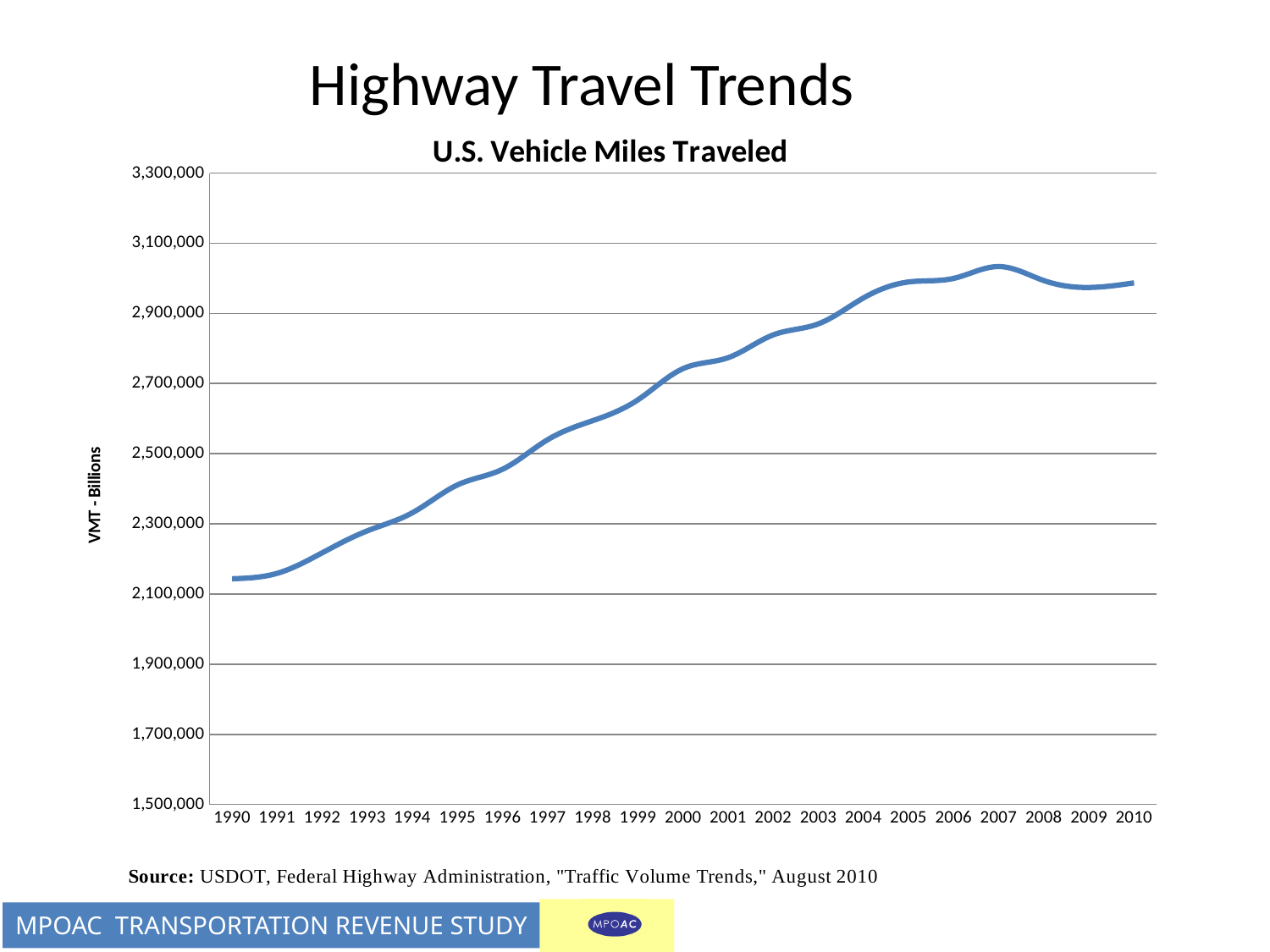
What is the title of the chart? U.S. Vehicle Miles Traveled Which year has the lowest vehicle miles traveled value? 1990 Is the value for 1995 greater or less than 2,500,000? less Is the value for 1990 greater or less than 2,300,000? less Is the value for 2007 greater or less than 3,100,000? less How many years are shown along the x axis of the chart? 21 Which year has the larger value, 2007 or 2009? 2007 Which year has the highest vehicle miles traveled value? 2007 Do the vehicle miles traveled values generally rise or fall from 1990 to 2007? rise What is the label on the vertical axis of the chart? VMT - Billions What kind of chart is shown on the slide? line chart